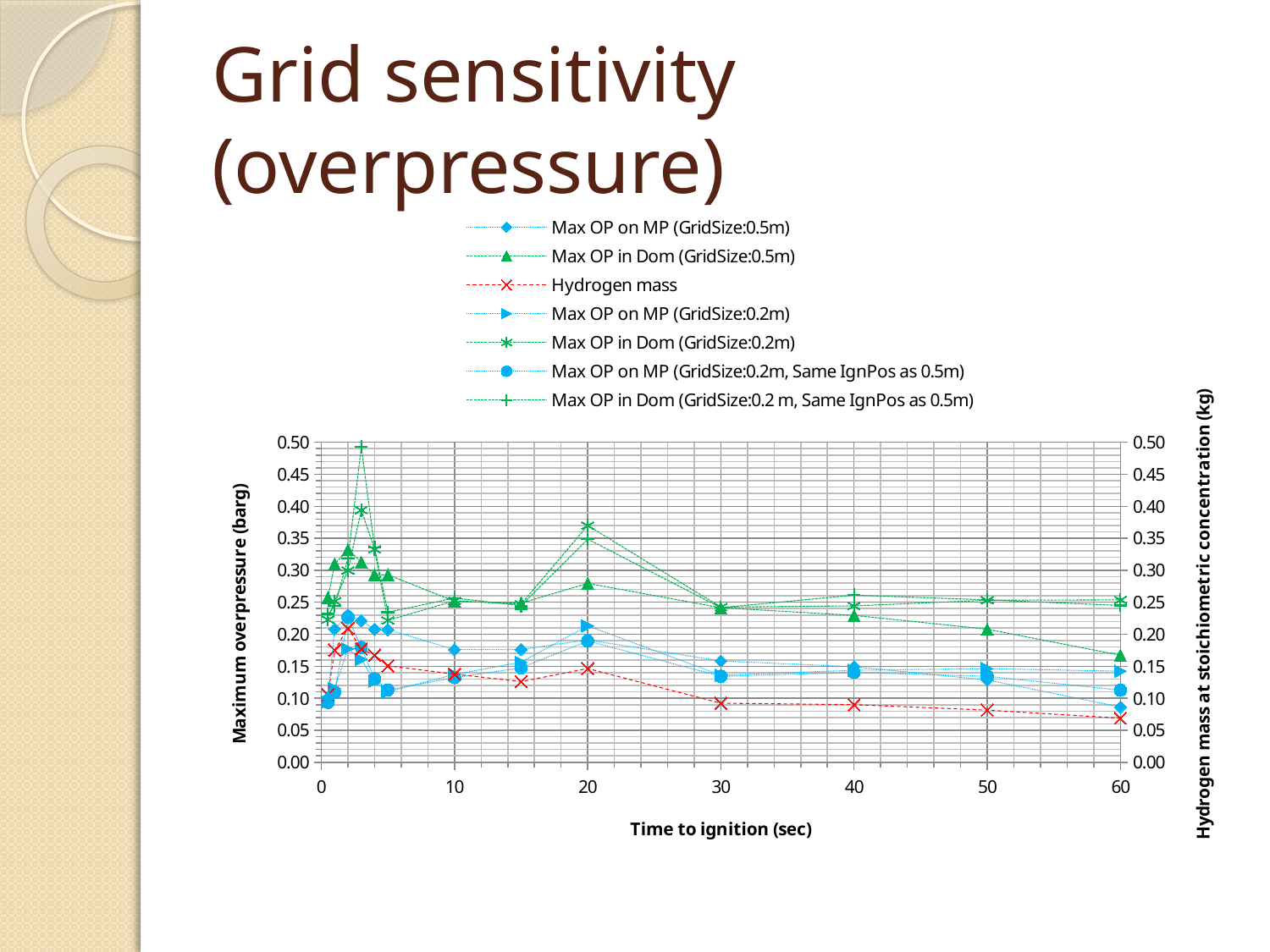
What is the label of the x axis? Time to ignition (sec) Is the Max OP in Dom (GridSize:0.5m) value at 60 sec greater or less than 0.20? less Which series reaches the highest value anywhere on the chart? Max OP in Dom (GridSize:0.2 m, Same IgnPos as 0.5m) Is the Hydrogen mass value at 60 sec greater or less than 0.10? less At 20 sec, which is larger: Max OP in Dom (GridSize:0.2m) or Max OP in Dom (GridSize:0.5m)? Max OP in Dom (GridSize:0.2m) At 60 sec, which is larger: Max OP in Dom (GridSize:0.5m) or Max OP on MP (GridSize:0.5m)? Max OP in Dom (GridSize:0.5m) Is the peak value of the Max OP in Dom (GridSize:0.2 m, Same IgnPos as 0.5m) series greater or less than 0.45? greater Does the Hydrogen mass series rise or fall between 20 sec and 60 sec? fall What kind of chart is shown on the slide? line chart How many series does the legend list? 7 What is the label of the left y axis? Maximum overpressure (barg)